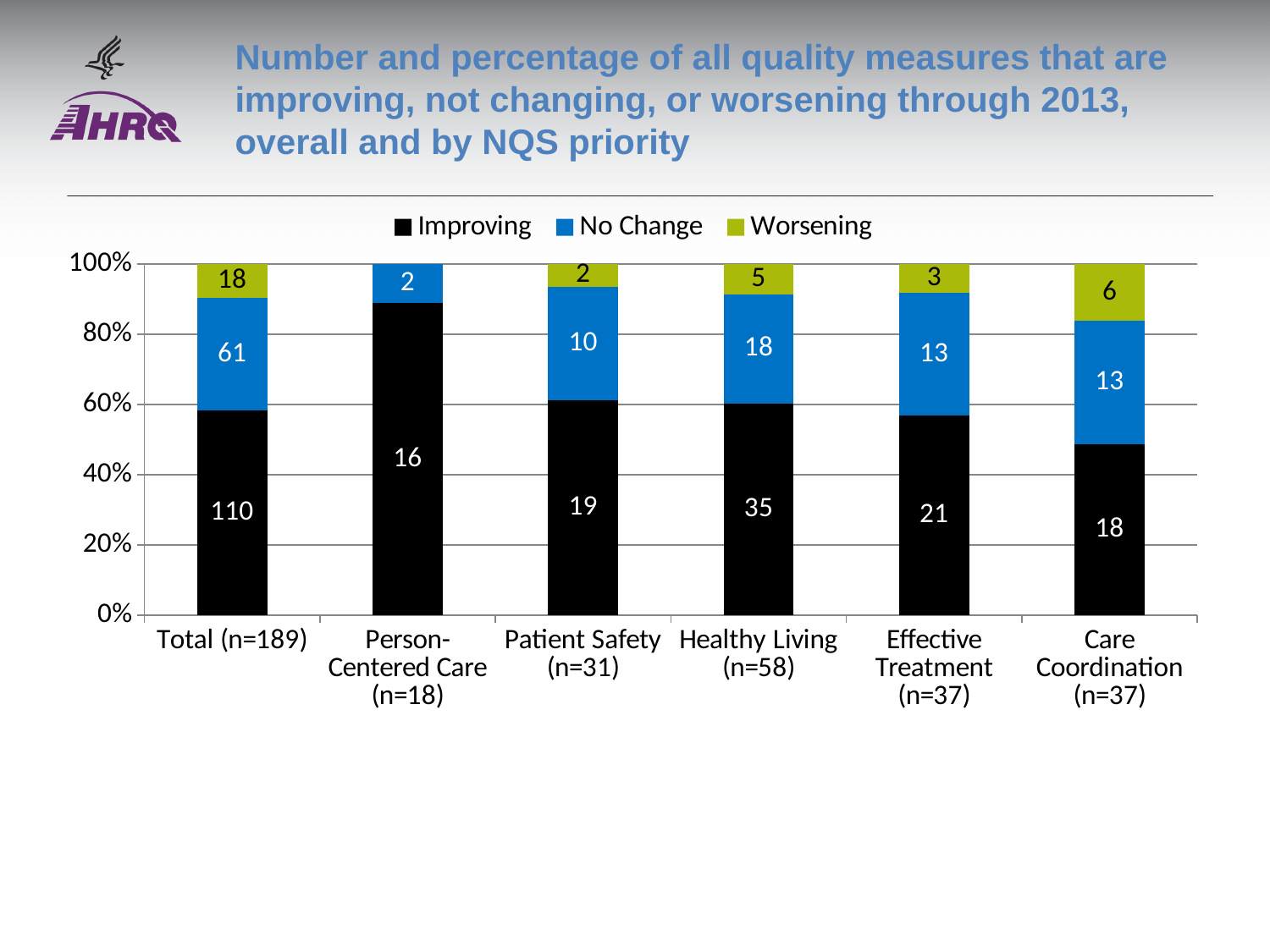
Among the NQS priority categories (excluding Total), which has the lowest Improving value? Person-Centered Care (n=18) What is the No Change value for Healthy Living (n=58)? 18 What type of chart is shown on the slide? Stacked bar chart What is the Worsening value for Care Coordination (n=37)? 6 What is the Improving value for Total (n=189)? 110 Which category has the highest Worsening value? Total (n=189) How many series does the legend list? 3 Which is larger, the No Change value for Patient Safety (n=31) or the No Change value for Care Coordination (n=37)? Care Coordination (n=37) How many categories are shown along the x axis? 6 What is the total of the Improving, No Change and Worsening values for Patient Safety (n=31)? 31 Is the Improving share of the Care Coordination (n=37) bar greater or less than 60%? less What is the difference between the Improving and No Change values for Effective Treatment (n=37)? 8